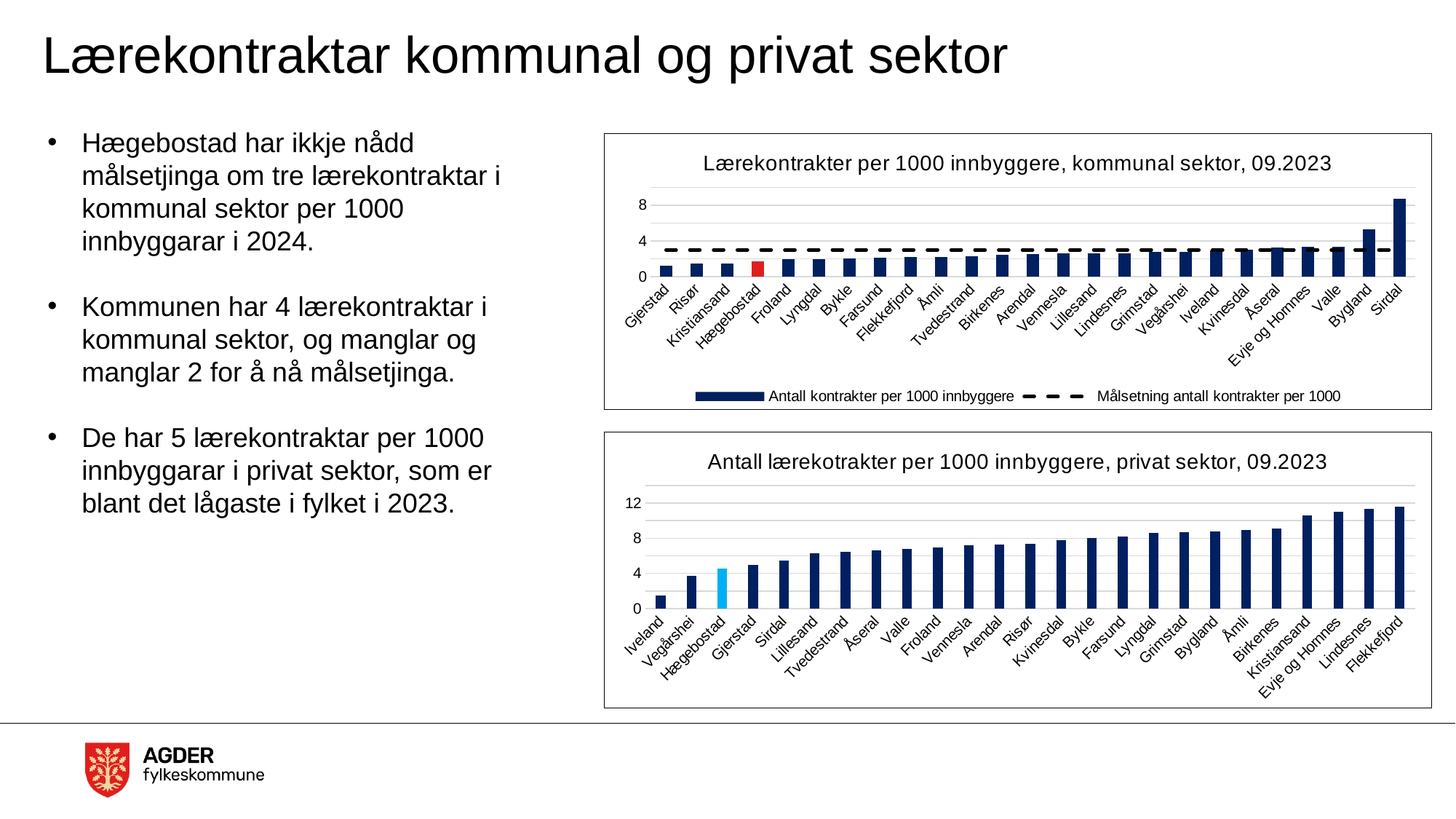
In the top chart (kommunal sektor), which municipality has the lowest number of contracts per 1000 inhabitants? Gjerstad In the bottom chart (privat sektor), which municipality has the highest value? Flekkefjord What kind of chart is the top chart, 'Lærekontrakter per 1000 innbyggere, kommunal sektor, 09.2023'? Combination bar and line chart (bars with a dashed target line) In the bottom chart (privat sektor), which municipality has the lowest value? Iveland How many series does the legend of the top chart (kommunal sektor) list? 2 In the top chart (kommunal sektor), is the value for Gjerstad greater or less than 4? less In the top chart (kommunal sektor), what colour is the bar for Hægebostad? Red In the top chart (kommunal sektor), which municipality has the highest number of contracts per 1000 inhabitants? Sirdal In the bottom chart (privat sektor), do the values rise or fall from left to right along the x axis? Rise How many municipalities are shown in the top chart (kommunal sektor)? 25 In the bottom chart (privat sektor), is the value for Kristiansand greater or less than 8? greater In the top chart (kommunal sektor), is the value for Sirdal greater or less than 8? greater